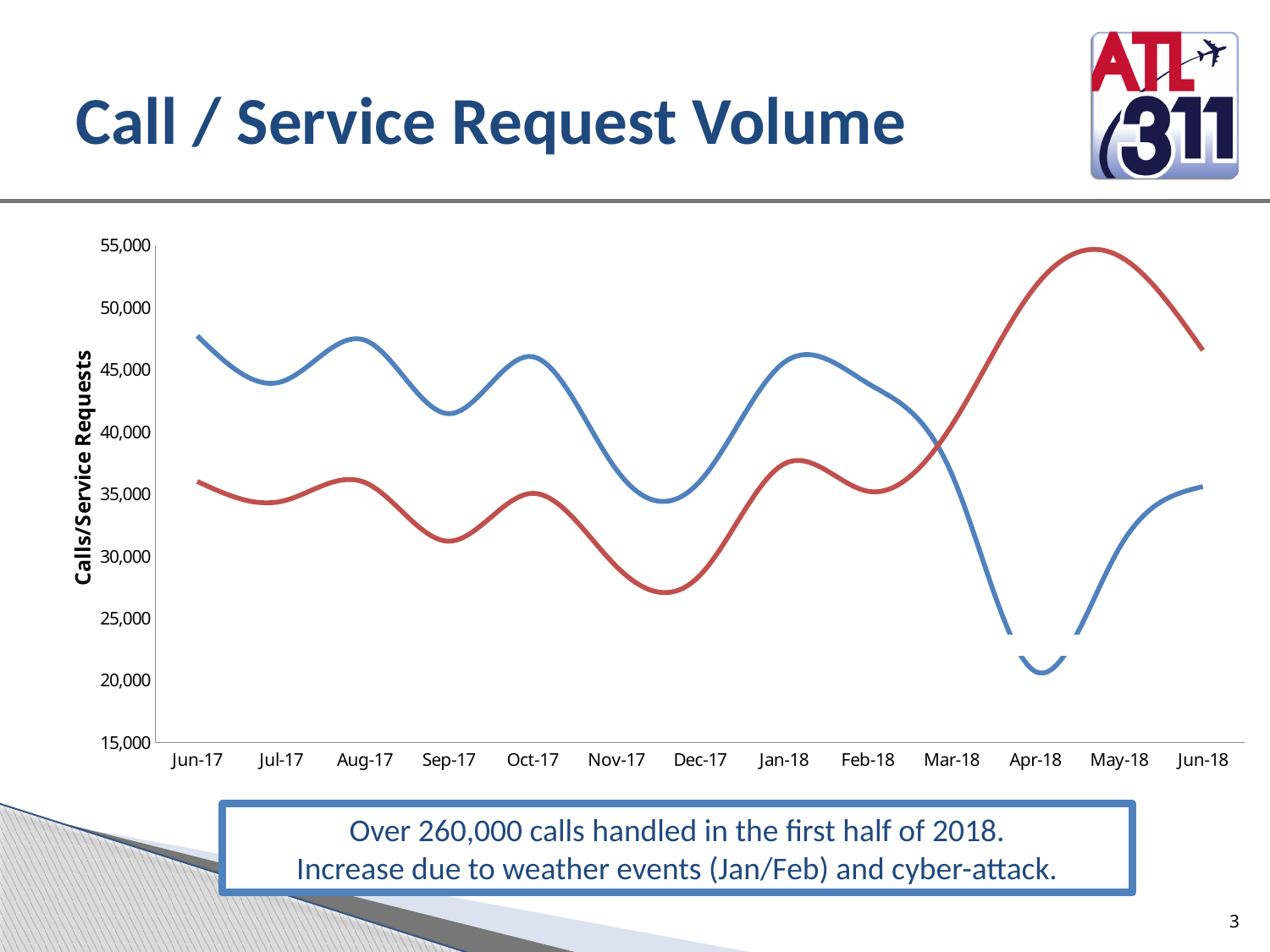
In which month does the blue line reach its lowest point? Apr-18 How many months are shown along the x axis of the chart? 13 How many lines are plotted on the chart? 2 What kind of chart is shown on the slide? line chart What is the title of the vertical axis of the chart? Calls/Service Requests Is the value of the red line for May-18 greater or less than 50,000? greater Which line has the higher value in Apr-18, the blue line or the red line? red line Which line has the higher value in Jun-17, the blue line or the red line? blue line Does the red line rise or fall from Feb-18 to May-18? rise Is the value of the red line for Dec-17 greater or less than 30,000? less In which month does the red line reach its highest point? May-18 Is the value of the blue line for Apr-18 greater or less than 25,000? less